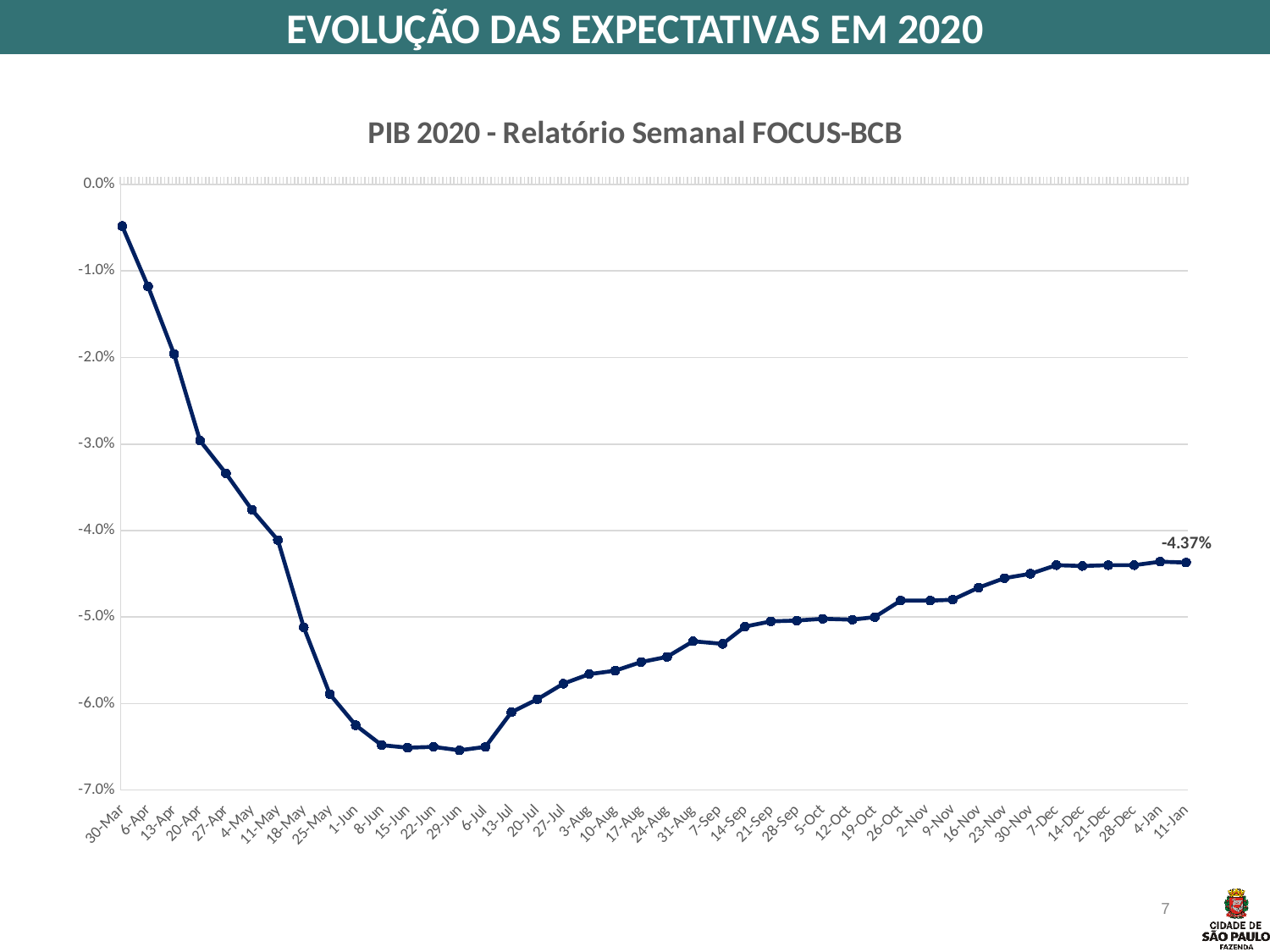
What kind of chart is shown on the slide? line chart What is the title of the chart? PIB 2020 - Relatório Semanal FOCUS-BCB Which date has the highest value on the chart? 30-Mar Is the value for 8-Jun greater or less than -6.0%? less Is the value for 30-Mar greater or less than -1.0%? greater Is the value for 26-Oct greater or less than -5.0%? greater Do the values rise or fall from 6-Jul to 11-Jan? rise Which is larger, the value for 6-Apr or the value for 8-Jun? 6-Apr What is the value shown by the data label at 11-Jan? -4.37% How many dates are shown on the x axis? 42 Do the values rise or fall from 30-Mar to 8-Jun? fall